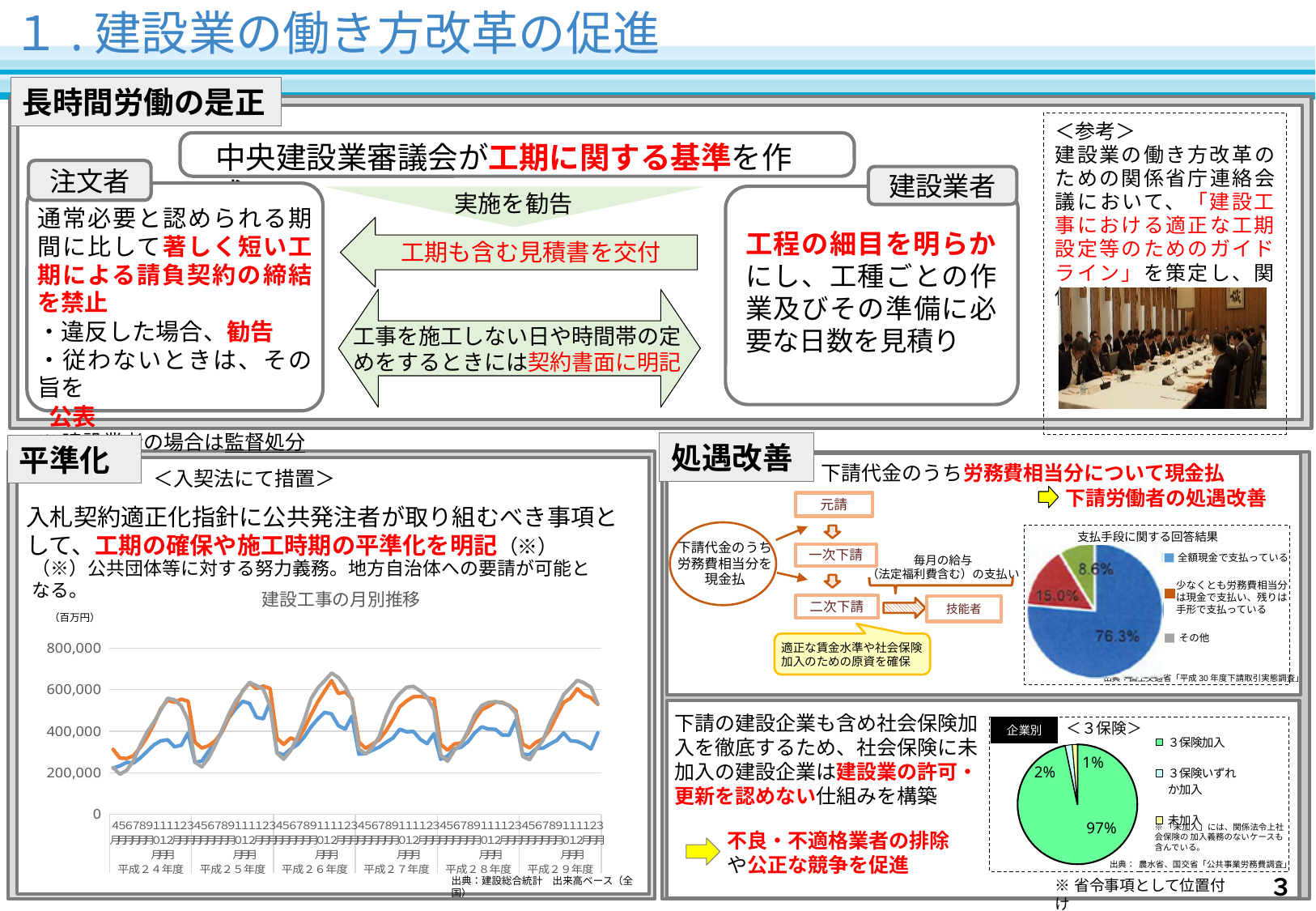
In the pie chart titled ＜3保険＞, what percentage of companies are 3保険加入? 97% In the pie chart titled ＜3保険＞, which category has the smallest share? 未加入 In the chart titled 建設工事の月別推移, is the highest plotted value greater or less than 800,000? less In the pie chart titled 支払手段に関する回答結果, what percentage of respondents answered 全額現金で支払っている? 76.3% What unit is shown on the y axis of the chart titled 建設工事の月別推移? 百万円 In the pie chart titled 支払手段に関する回答結果, which response has the largest share? 全額現金で支払っている What kind of chart is the chart titled 建設工事の月別推移? Line chart How many entries does the legend of the pie chart titled 支払手段に関する回答結果 list? 3 How many fiscal years (年度) are shown along the x axis of the chart titled 建設工事の月別推移? 6 In the pie chart titled 支払手段に関する回答結果, what percentage corresponds to その他? 8.6% In the pie chart titled 支払手段に関する回答結果, what is the difference in percentage points between 全額現金で支払っている and 少なくとも労務費相当分は現金で支払い、残りは手形で支払っている? 61.3